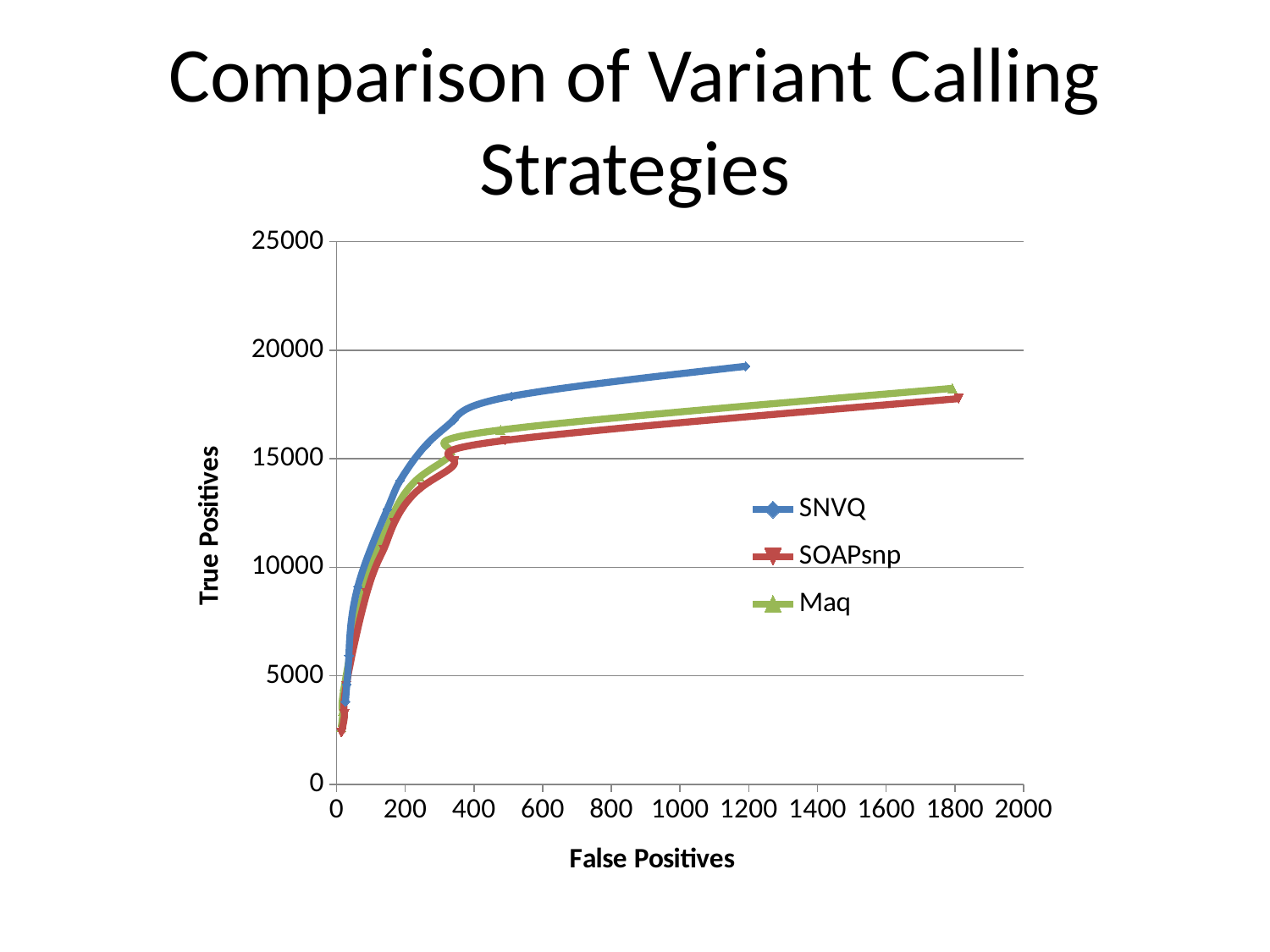
Do the True Positives values rise or fall as False Positives increase along the x axis? rise What kind of chart is shown on the slide? line chart How many series does the legend list? 3 Is the largest False Positives value reached by SNVQ greater or less than 1400? less Which series reaches the highest number of True Positives? SNVQ Is the lowest True Positives value of the SOAPsnp series greater or less than 5000? less Is the largest False Positives value reached by Maq greater or less than 1600? greater What is the label of the x axis? False Positives What is the title of the chart? Comparison of Variant Calling Strategies At 1800 False Positives, which series has more True Positives, Maq or SOAPsnp? Maq